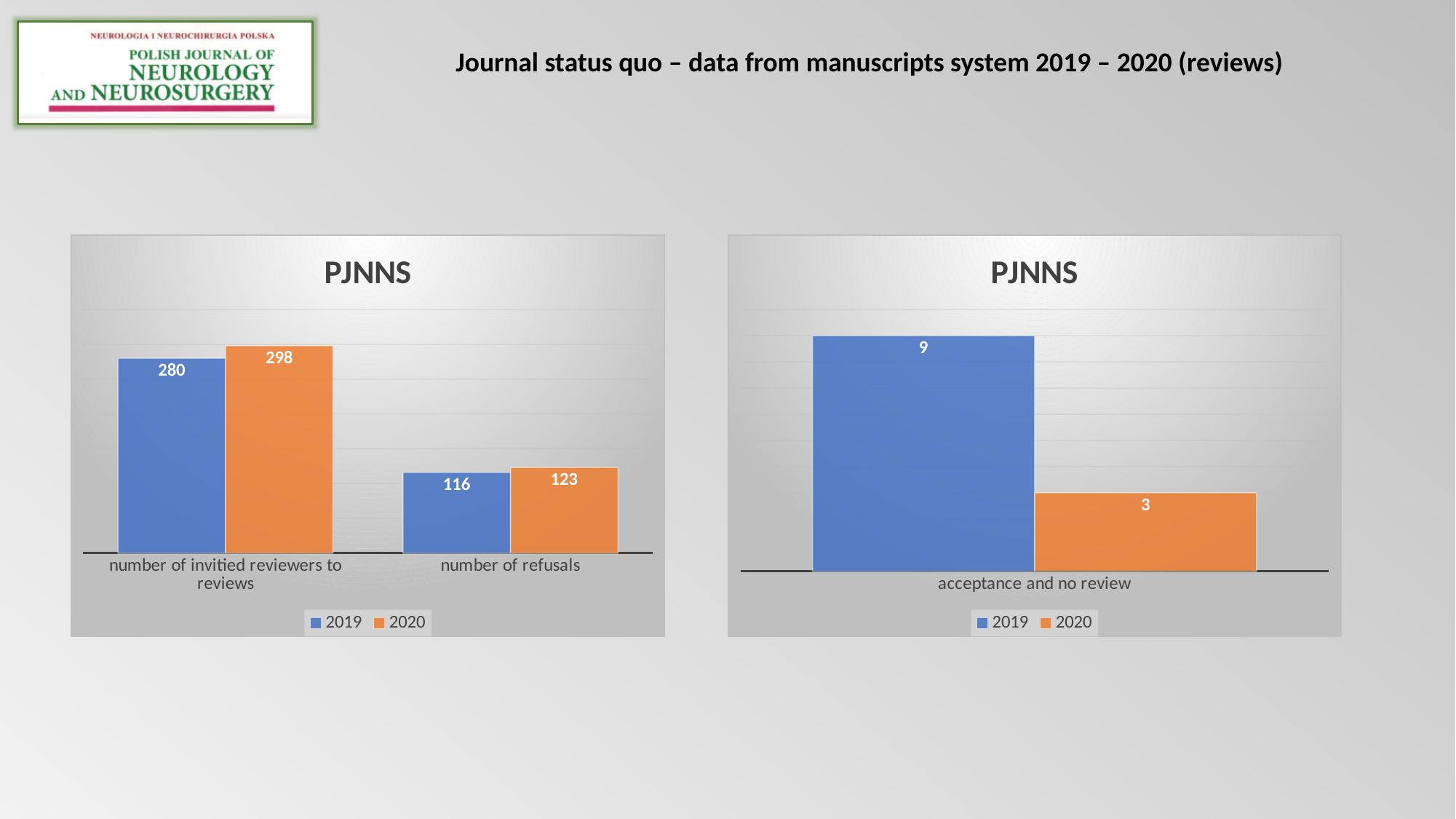
In the left chart, which year has the higher number of refusals, 2019 or 2020? 2020 In the right chart, what is the value for acceptance and no review in 2020? 3 In the left chart, what is the number of invited reviewers to reviews for 2019? 280 In the left chart, how many categories are shown on the x axis? 2 In the left chart, what is the number of invited reviewers to reviews for 2020? 298 In the left chart, what is the number of refusals for 2019? 116 In the right chart, what is the difference between the 2019 and 2020 values for acceptance and no review? 6 How many series does the legend of the right chart list? 2 What type of chart is the left chart? Bar chart In the left chart, what is the number of refusals for 2020? 123 In the left chart, by how much did the number of invited reviewers to reviews increase from 2019 to 2020? 18 In the right chart, what is the value for acceptance and no review in 2019? 9